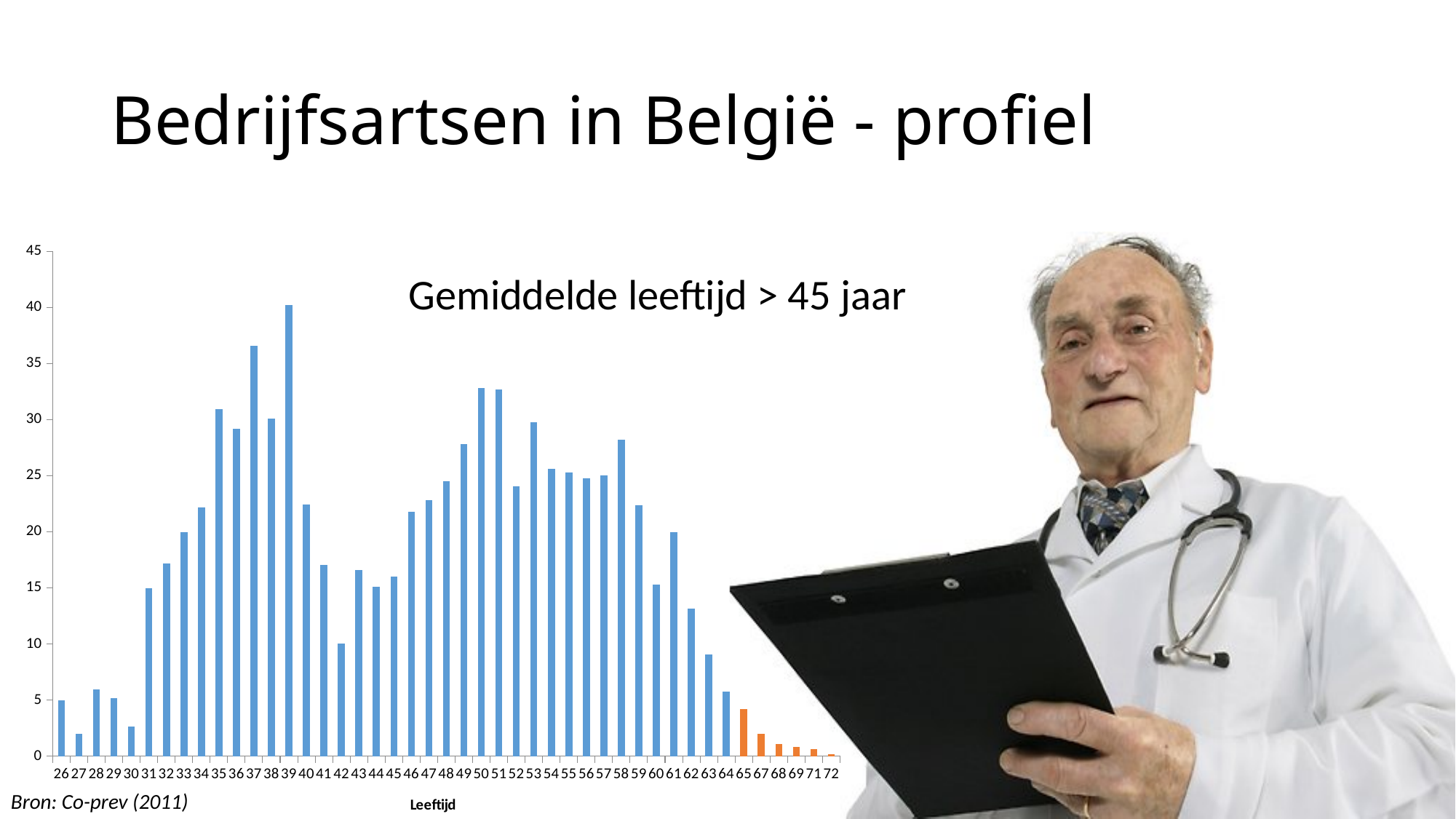
Is the value for age 50 greater or less than 30? greater Which age has the highest bar in the chart? 39 What is the label of the x axis of the chart? Leeftijd Is the value for age 65 greater or less than 5? less Is the value for age 27 greater or less than 5? less What text annotation is placed inside the chart area? Gemiddelde leeftijd > 45 jaar What kind of chart is shown on the slide? bar chart Which age has the lowest bar in the chart? 72 Which is larger, the value for age 37 or the value for age 39? 39 Which is larger, the value for age 39 or the value for age 50? 39